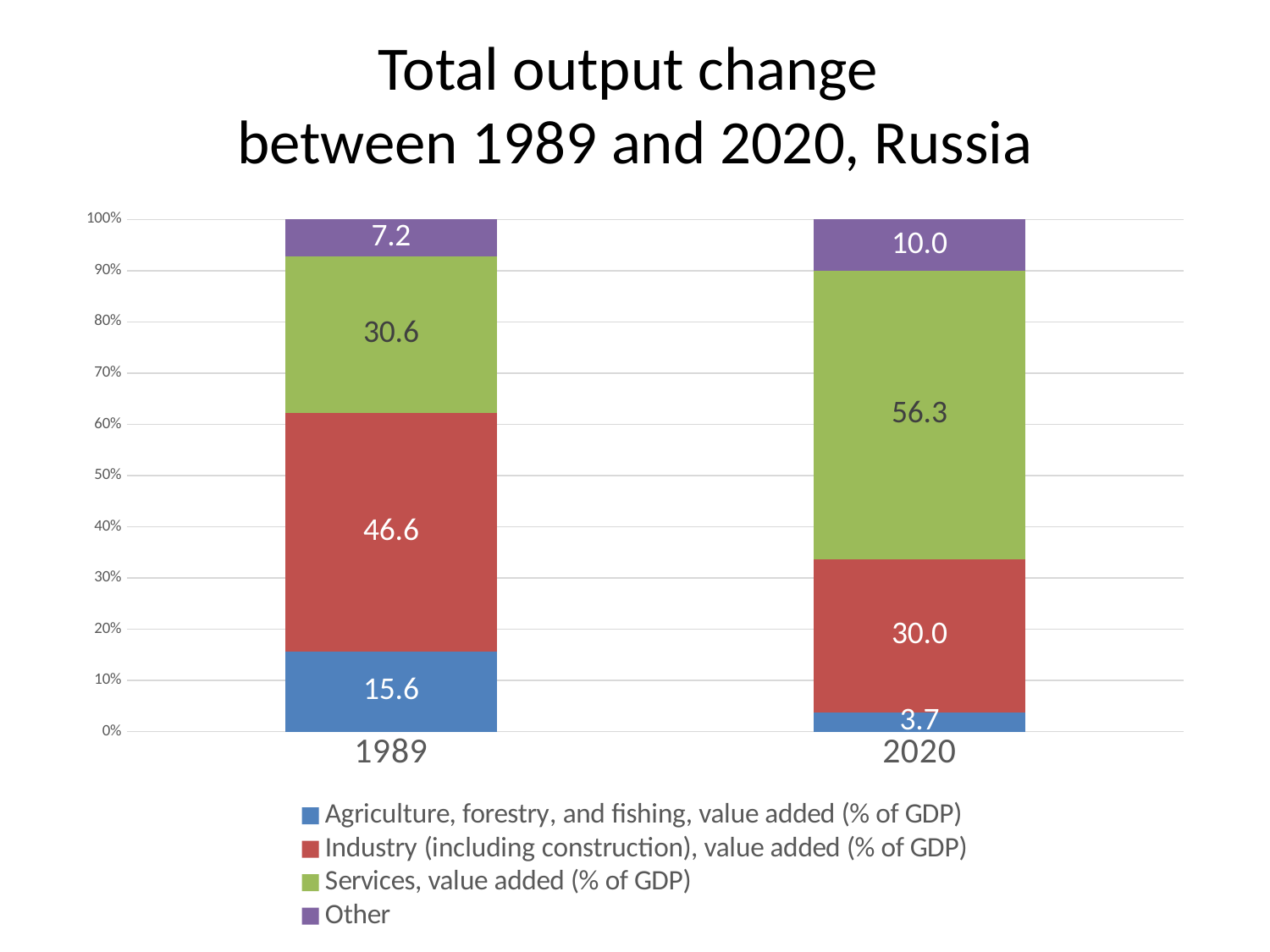
What is the value for Industry (including construction), value added (% of GDP) in 1989? 46.6 How many categories are shown on the x axis? 2 What is the title of the chart? Total output change between 1989 and 2020, Russia Which is larger: the Industry value in 1989 or the Industry value in 2020? 1989 What is the value for Services, value added (% of GDP) in 2020? 56.3 Which series has the smallest value in the 2020 bar? Agriculture, forestry, and fishing, value added (% of GDP) Which series has the largest value in the 1989 bar? Industry (including construction), value added (% of GDP) What is the value for Other in 1989? 7.2 What is the value for Agriculture, forestry, and fishing, value added (% of GDP) in 2020? 3.7 How many series does the legend list? 4 What kind of chart is shown on the slide? Stacked bar chart What is the difference between the Services value in 2020 and in 1989? 25.7